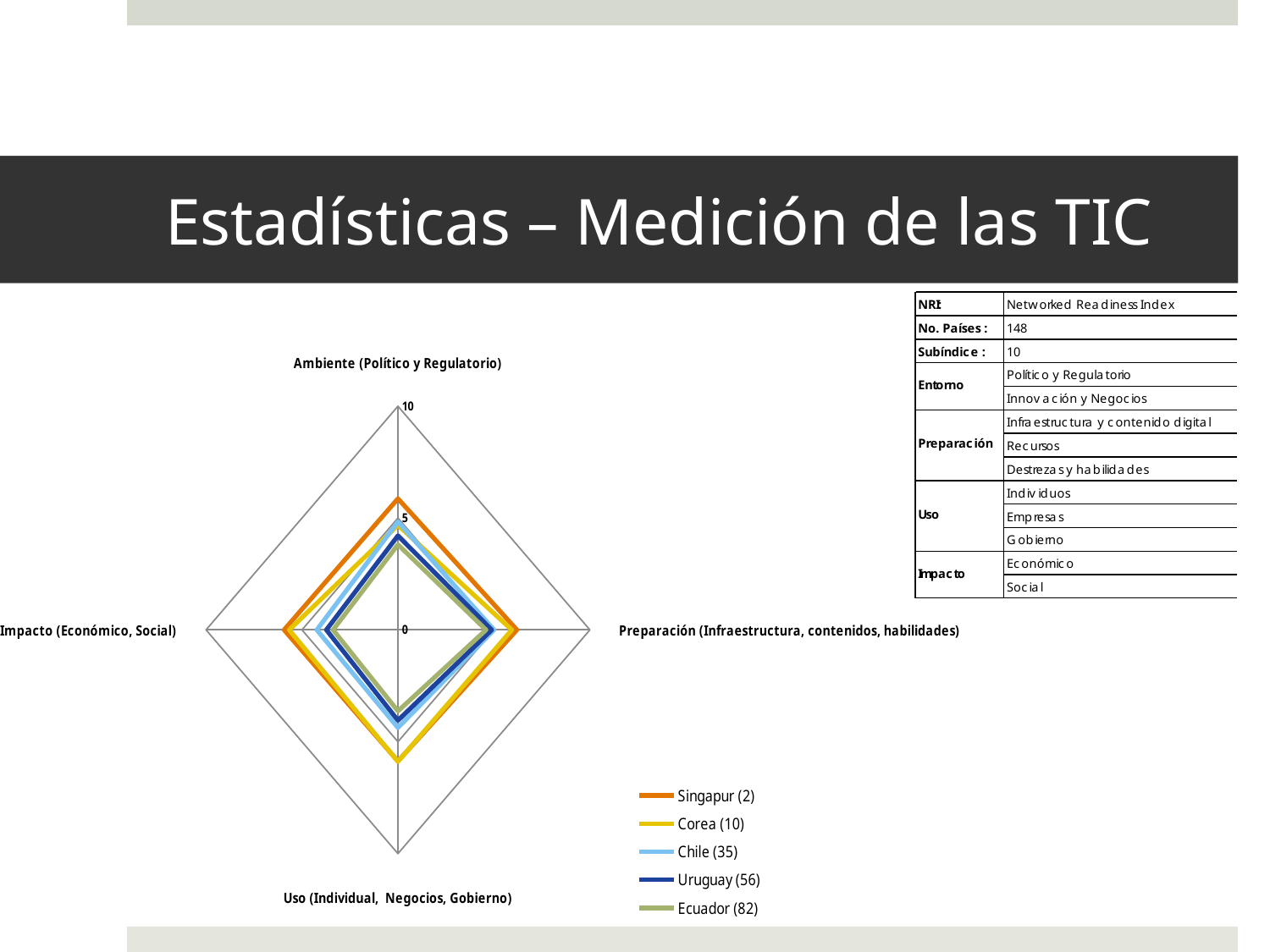
Which series has the lowest value on the Ambiente (Político y Regulatorio) axis? Ecuador (82) Is the value for Ecuador (82) on the Uso (Individual, Negocios, Gobierno) axis greater or less than 5? less On the Ambiente (Político y Regulatorio) axis, which is larger: Singapur (2) or Ecuador (82)? Singapur (2) What is the maximum value shown on the radar chart's axis scale? 10 Which series has the highest value on the Ambiente (Político y Regulatorio) axis? Singapur (2) Which series is drawn in orange on the radar chart? Singapur (2) What kind of chart is shown on the slide? Radar chart Is the value for Ecuador (82) on the Impacto (Económico, Social) axis greater or less than 5? less Is the value for Singapur (2) on the Ambiente (Político y Regulatorio) axis greater or less than 5? greater How many series does the legend of the radar chart list? 5 How many axes (categories) does the radar chart have? 4